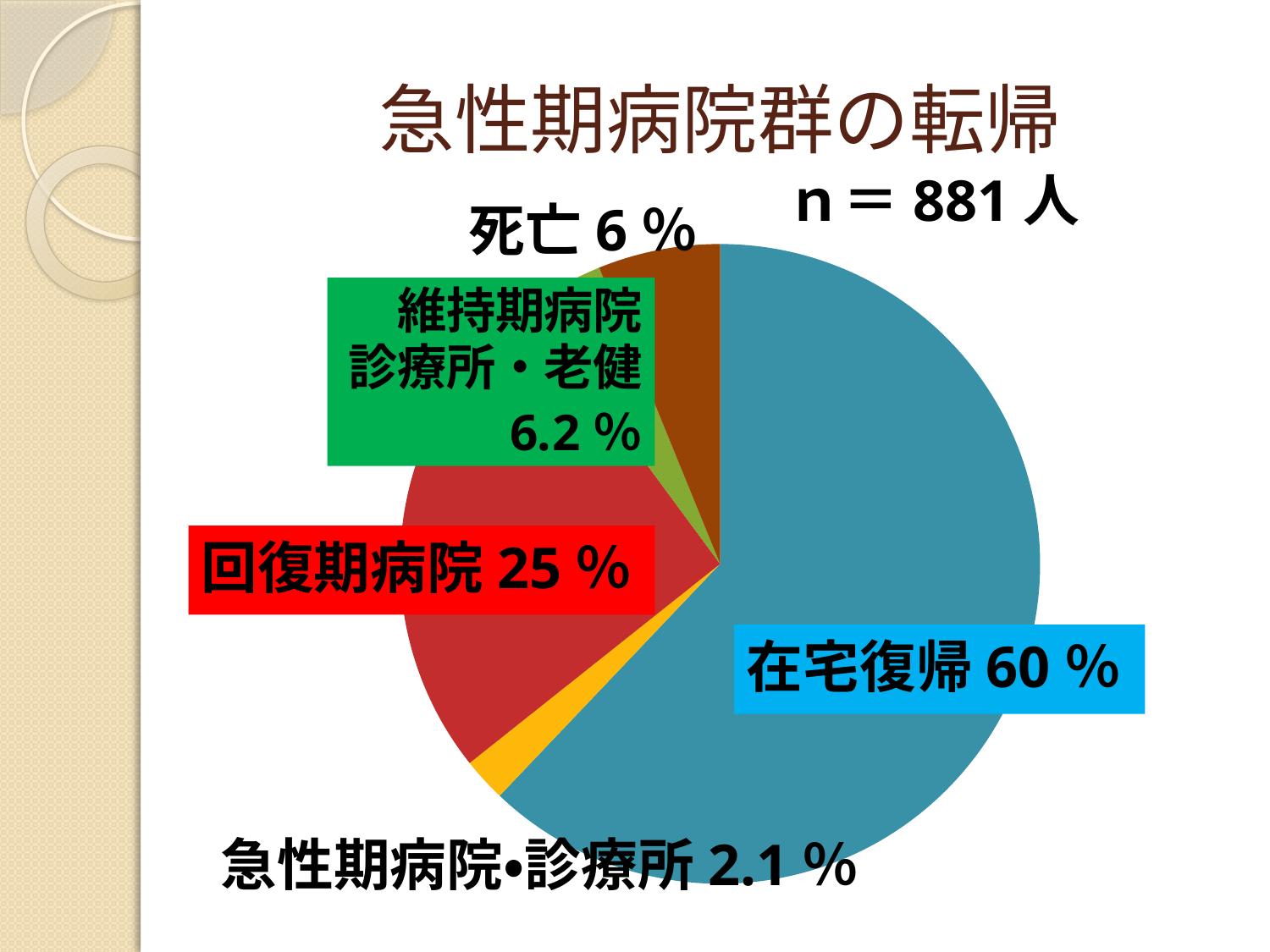
What percentage of the pie is 急性期病院•診療所? 2.1 % What percentage of the pie is 維持期病院 診療所・老健? 6.2 % What percentage of the pie is 回復期病院? 25 % Which category has the largest share of the pie? 在宅復帰 How many slices does the pie chart have? 5 What is the title of the chart? 急性期病院群の転帰 What kind of chart is shown on the slide? pie chart What percentage of the pie is 死亡? 6 % What percentage of the pie is 在宅復帰? 60 % What is the sample size (n) shown on the slide? 881 人 What is the difference in percentage points between 在宅復帰 and 回復期病院? 35 % Which category has the smallest share of the pie? 急性期病院•診療所